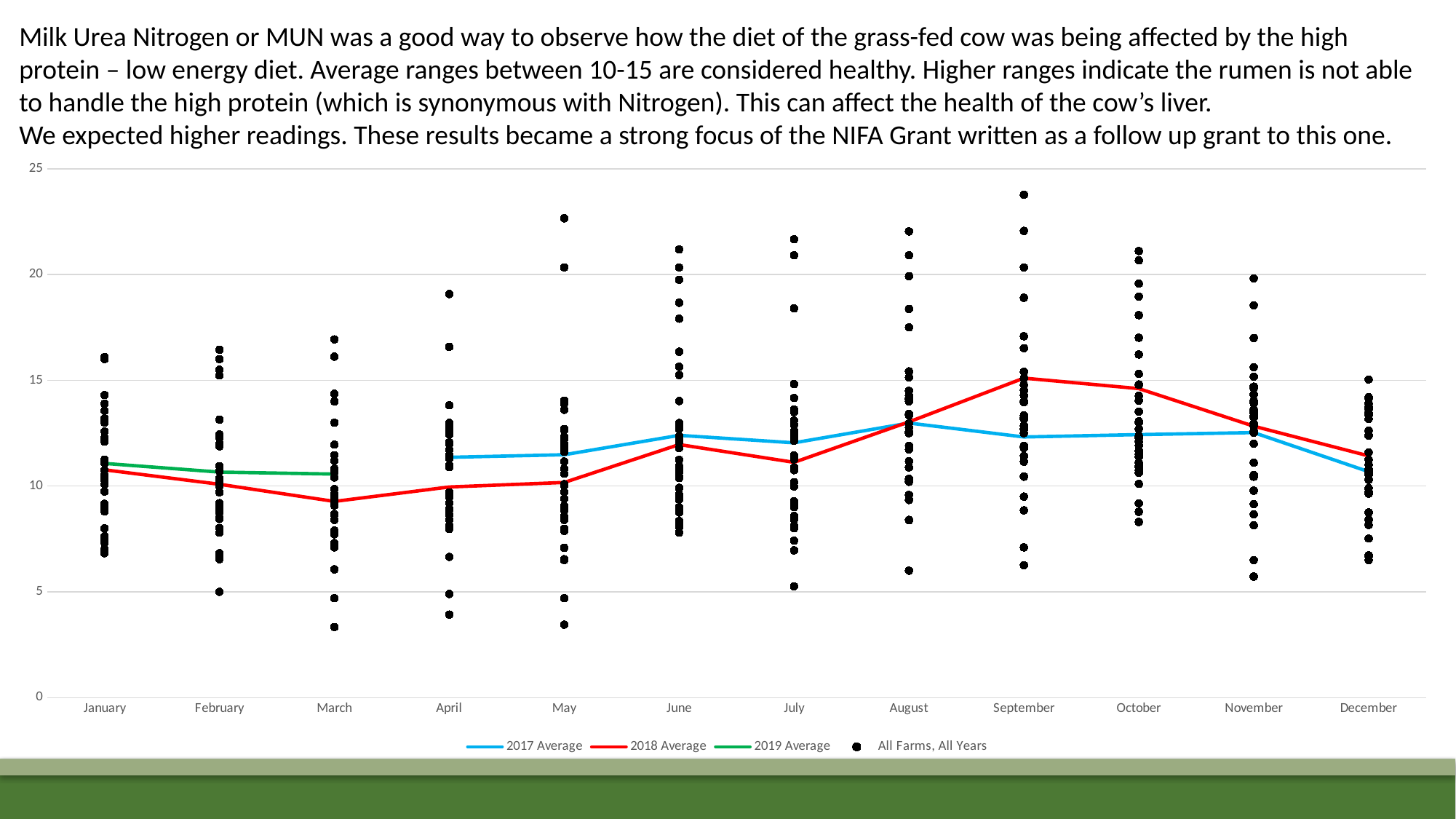
In May, which is higher: the 2017 Average or the 2018 Average? 2017 Average Does the 2019 Average rise or fall from January to March? fall Is the 2017 Average for August greater or less than 15? less Is the 2018 Average for October greater or less than 10? greater Is the 2018 Average for March greater or less than 10? less Which legend entry is shown as black dots rather than a line? All Farms, All Years How many months are shown along the x axis? 12 In which month is the 2018 Average at its lowest? March In which month does the 2018 Average reach its highest value? September How many series does the legend list? 4 What kind of chart is shown on the slide? line chart In September, which is higher: the 2017 Average or the 2018 Average? 2018 Average